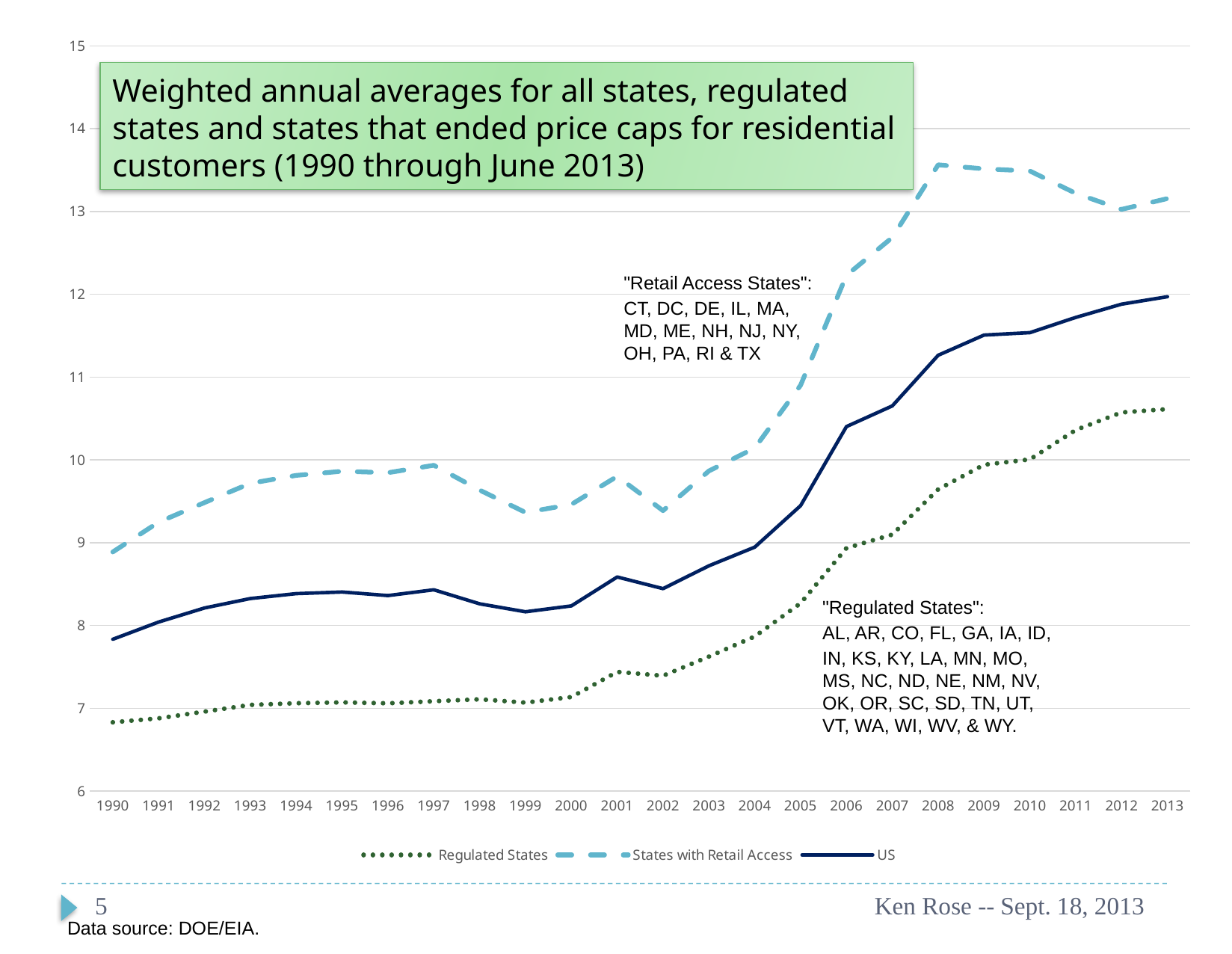
In which year is the US series at its lowest value? 1990 Is the value for US in 1990 greater or less than 8? less Does the Regulated States series rise or fall from 2000 to 2013? rises Which series is drawn with a dashed line? States with Retail Access In 2013, which is higher: the US series or the Regulated States series? US In which year is the States with Retail Access series at its lowest value? 1990 Is the value for Regulated States in 1990 greater or less than 7? less How many series does the legend list? 3 How many years are plotted along the x axis? 24 Which series has the highest value in 2008? States with Retail Access What kind of chart is shown on the slide? line chart Is the value for States with Retail Access in 2008 greater or less than 13? greater